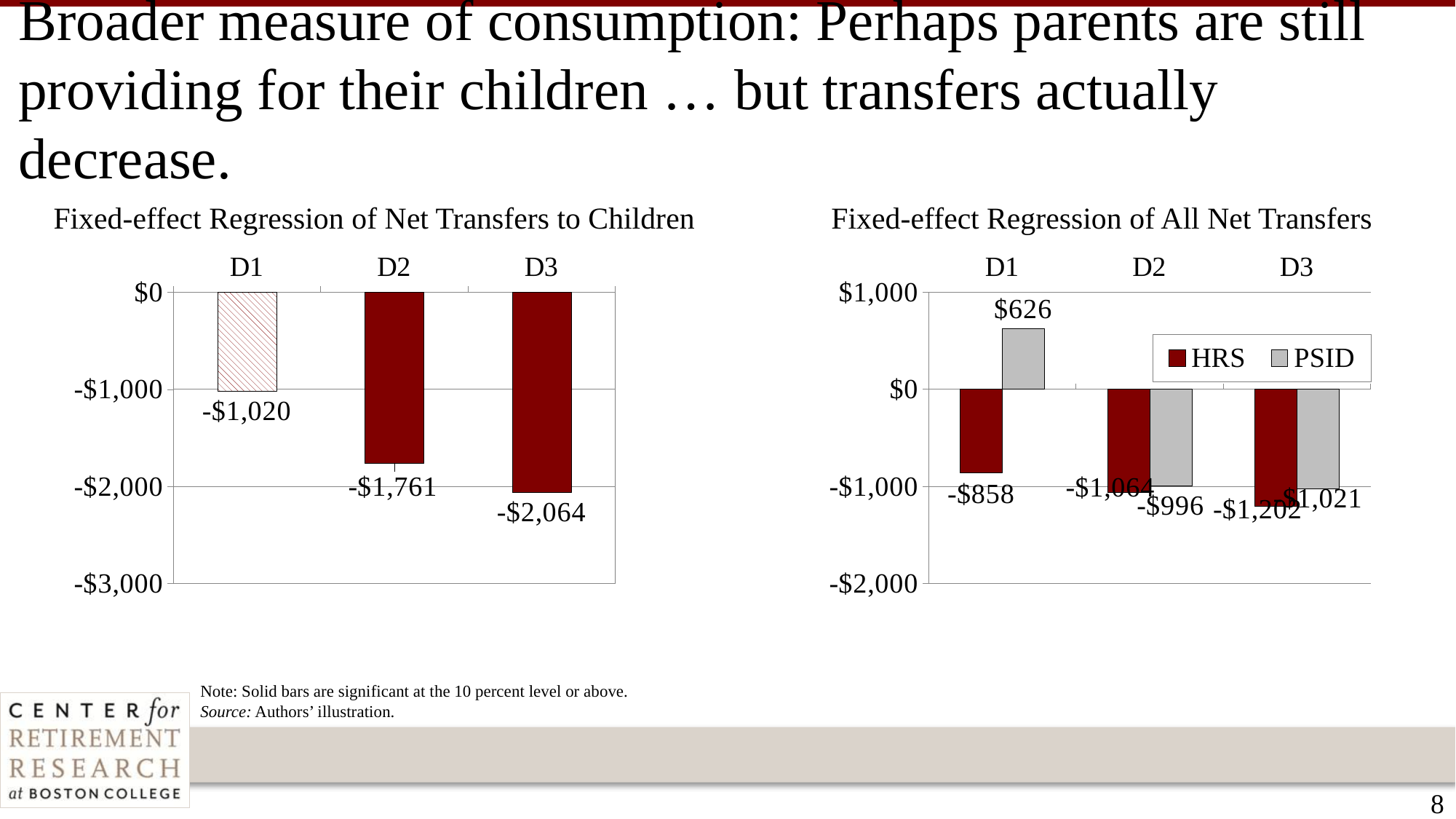
In the 'Fixed-effect Regression of Net Transfers to Children' chart, how many categories are shown? 3 In the 'Fixed-effect Regression of All Net Transfers' chart, what is the HRS value for D3? -$1,202 In the 'Fixed-effect Regression of Net Transfers to Children' chart, what is the value for D3? -$2,064 In the 'Fixed-effect Regression of Net Transfers to Children' chart, which category has the lowest (most negative) value? D3 In the 'Fixed-effect Regression of All Net Transfers' chart, what is the PSID value for D1? $626 In the 'Fixed-effect Regression of All Net Transfers' chart, which is larger for D2: the HRS value or the PSID value? PSID In the 'Fixed-effect Regression of Net Transfers to Children' chart, do the values rise or fall from D1 to D3? fall In the 'Fixed-effect Regression of Net Transfers to Children' chart, what is the difference between the D1 and D3 values? $1,044 In the 'Fixed-effect Regression of Net Transfers to Children' chart, what is the value for D2? -$1,761 What kind of chart is the 'Fixed-effect Regression of All Net Transfers' chart? bar chart In the 'Fixed-effect Regression of All Net Transfers' chart, how many series does the legend list? 2 In the 'Fixed-effect Regression of All Net Transfers' chart, what is the difference between the HRS and PSID values for D3? $181